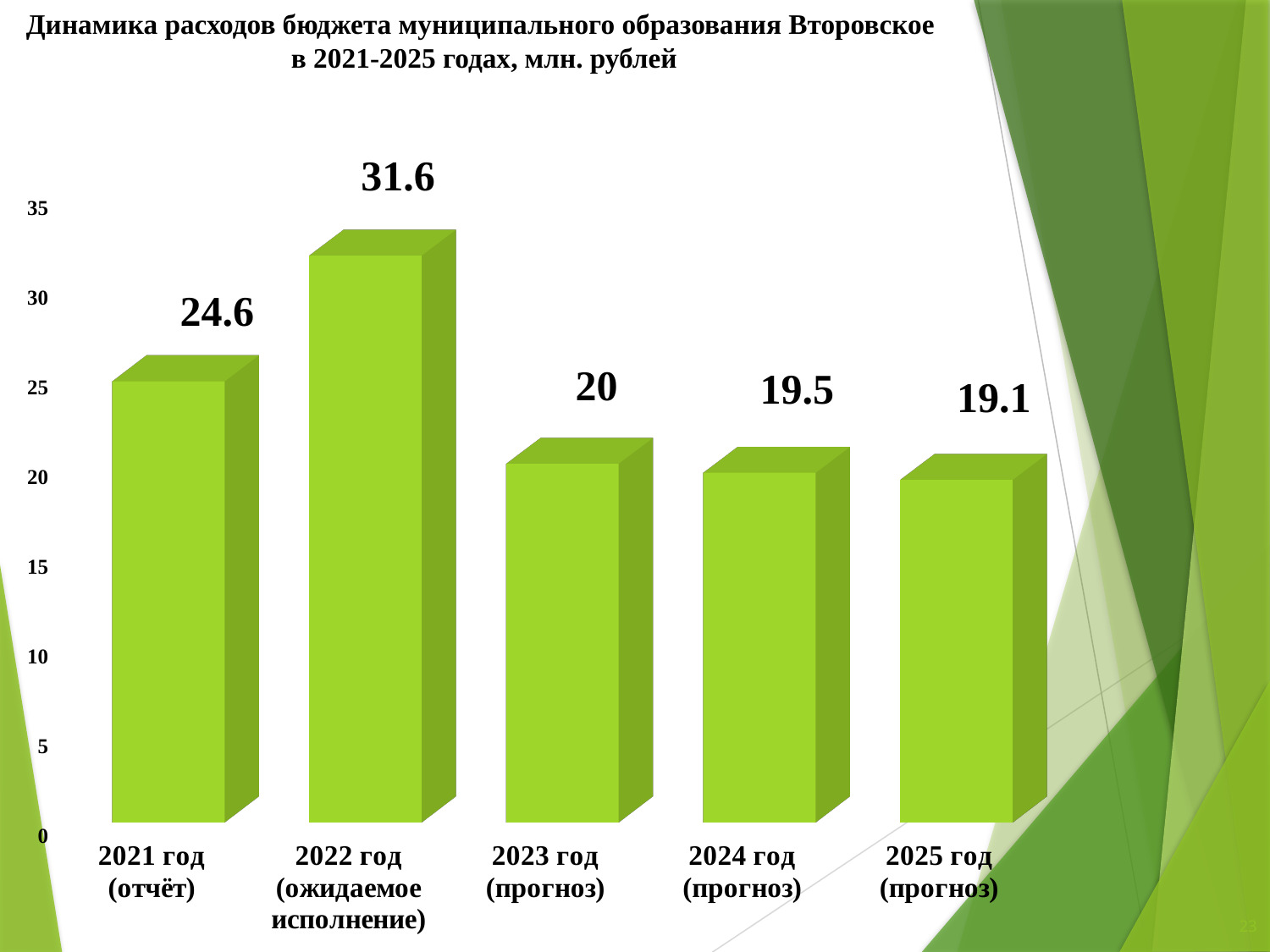
What is the difference between the values for 2023 год and 2025 год? 0.9 Which year has the highest value? 2022 год (ожидаемое исполнение) What is the value for 2022 год (ожидаемое исполнение)? 31.6 What is the value for 2025 год (прогноз)? 19.1 How many years are shown on the chart? 5 Which year has the lowest value? 2025 год (прогноз) What is the value for 2021 год (отчёт)? 24.6 Do the values rise or fall from 2022 год to 2025 год? fall Which is larger, the value for 2021 год or the value for 2023 год? 2021 год What is the difference between the values for 2022 год and 2021 год? 7 Is the value for 2022 год greater or less than 30? greater What kind of chart is shown on the slide? bar chart